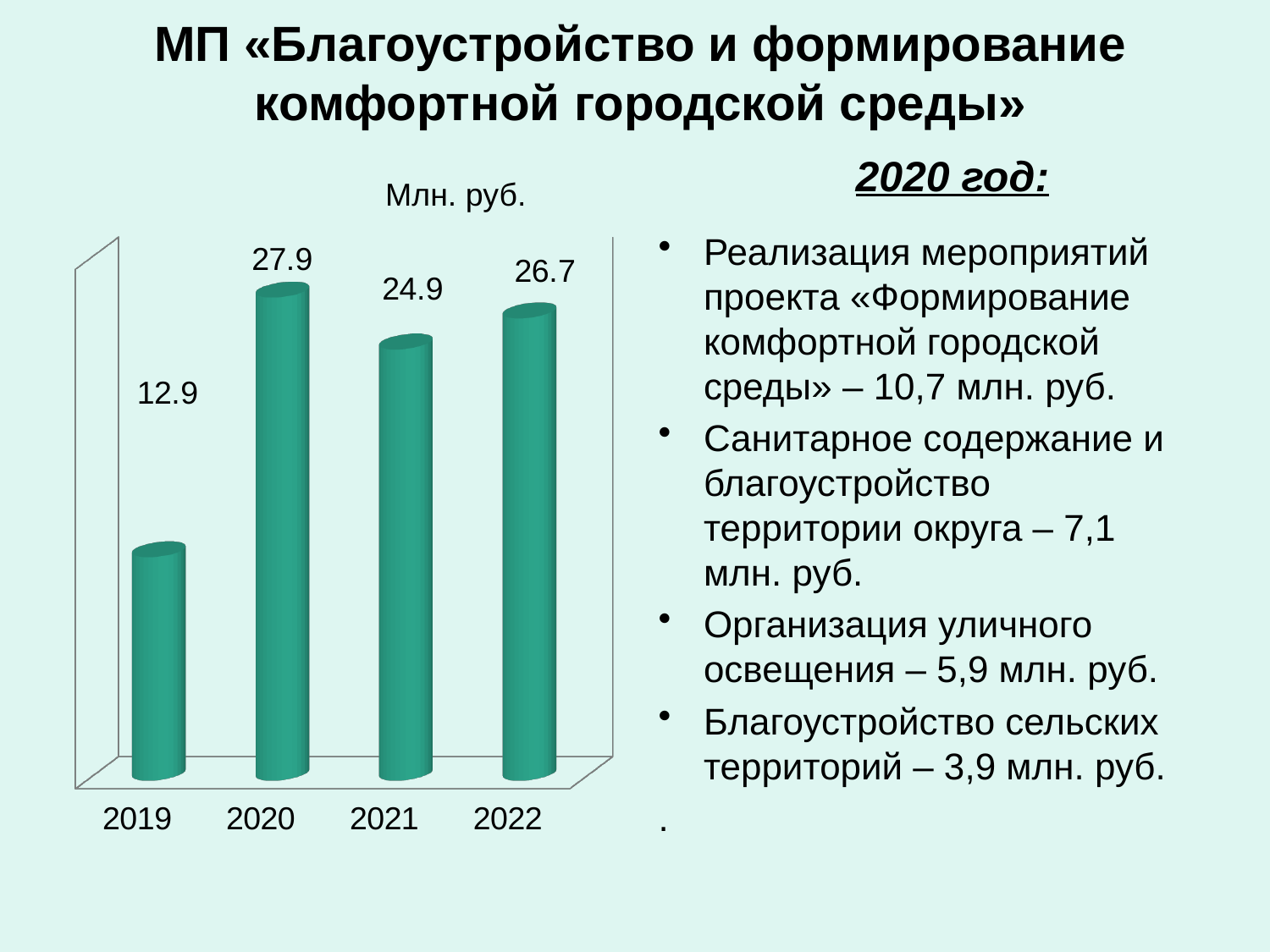
What is the difference between the values for 2020 and 2019? 15.0 What is the difference between the values for 2022 and 2021? 1.8 Which is larger, the value for 2021 or the value for 2022? 2022 Which year has the lowest value in the chart? 2019 What is the value for 2020 in the chart? 27.9 Which year has the highest value in the chart? 2020 What kind of chart is shown on the slide? bar chart How many years are shown on the x axis of the chart? 4 What is the value for 2019 in the chart? 12.9 What is the value for 2022 in the chart? 26.7 What is the value for 2021 in the chart? 24.9 What is the title of the chart? Млн. руб.